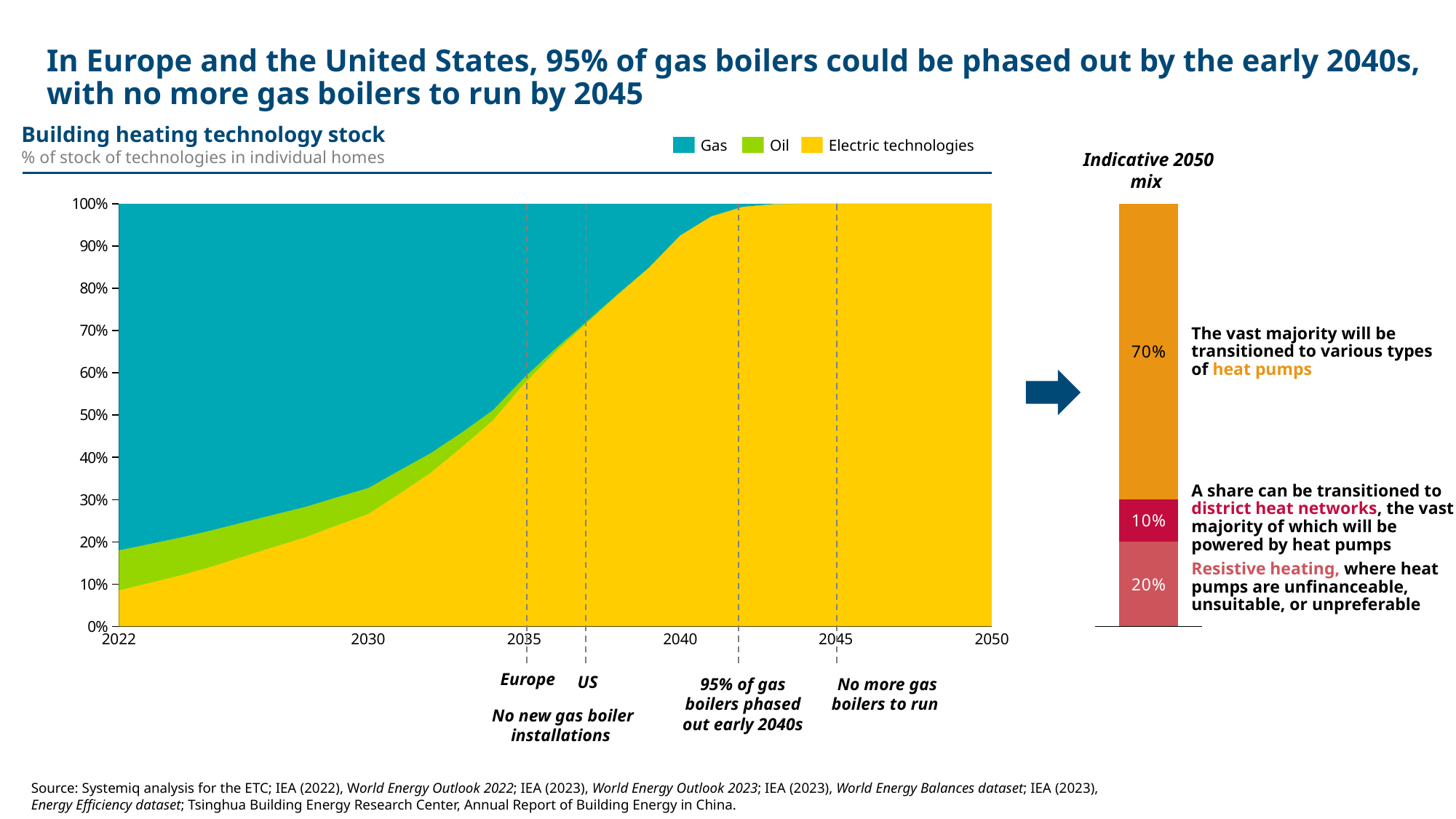
In the 'Indicative 2050 mix' bar, which segment has the smallest share? District heat networks In the 'Indicative 2050 mix' bar, what share is labelled for resistive heating? 20% In the 'Building heating technology stock' chart, does the share of Electric technologies rise or fall from 2022 to 2050? Rise In the 'Indicative 2050 mix' bar, what share is labelled for heat pumps? 70% In the 'Indicative 2050 mix' bar, what share is labelled for district heat networks? 10% In the 'Indicative 2050 mix' bar, which is larger: the resistive heating share or the district heat networks share? Resistive heating In the 'Building heating technology stock' chart, is the share of Electric technologies in 2035 greater or less than 50%? greater In the 'Building heating technology stock' chart, which series is shown in teal? Gas In the 'Indicative 2050 mix' bar, which segment has the largest share? Heat pumps What kind of chart is the 'Building heating technology stock' chart? Stacked area chart In the 'Indicative 2050 mix' bar, how many percentage points larger is the heat pumps share than the resistive heating share? 50 percentage points In the 'Building heating technology stock' chart, how many series does the legend list? 3